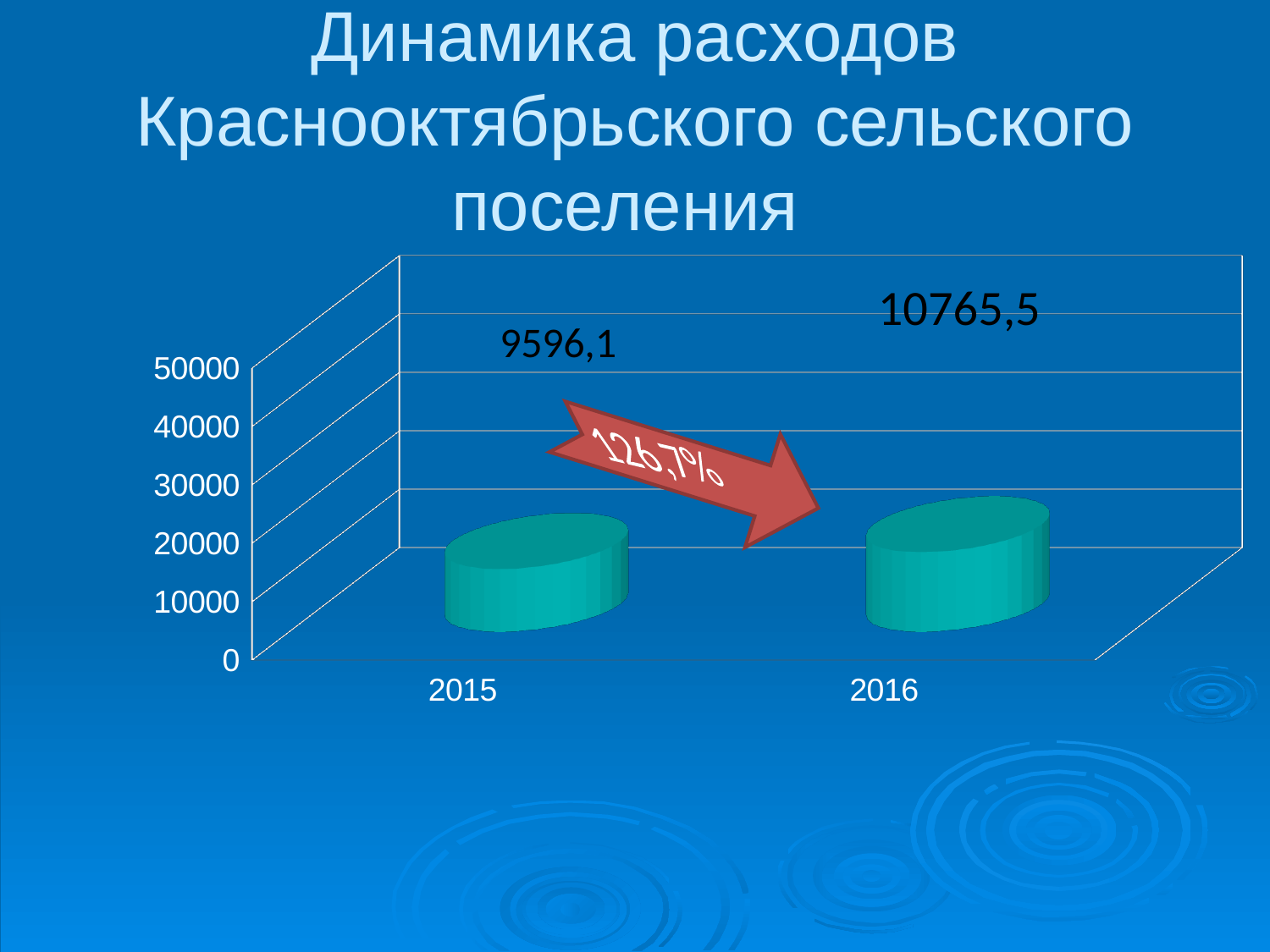
Which year has the higher value? 2016 What kind of chart is shown on the slide? Bar chart Is the value for 2016 larger than the value for 2015? Yes Do the values rise or fall from 2015 to 2016? Rise What percentage is written on the red arrow between the bars? 126,7% How many categories are shown on the x axis? 2 Which year has the lower value? 2015 Is the value for 2016 greater or less than 10000? greater